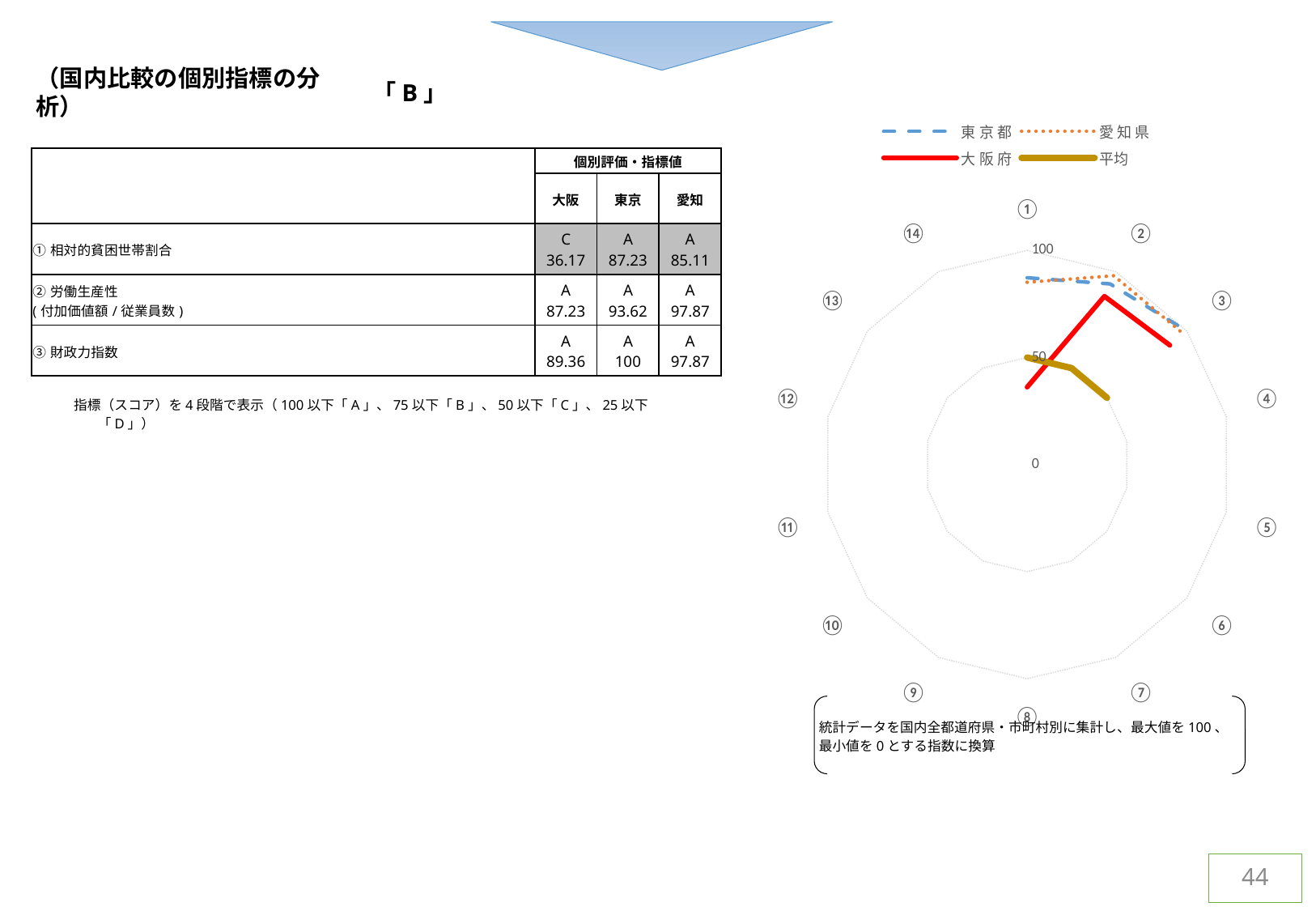
Which series in the radar chart is drawn as a solid red line? 大阪府 In the radar chart, which is larger at category ①: 大阪府 or 東京都? 東京都 Which series in the radar chart is drawn as a dotted orange line? 愛知県 In the radar chart, is the value for 東京都 at category ① greater or less than 50? greater In the radar chart, is the value for 大阪府 at category ② greater or less than 50? greater How many series does the legend of the radar chart list? 4 How many numbered categories are arranged around the radar chart? 14 In the radar chart, is the value for 大阪府 at category ① greater or less than 50? less What kind of chart is shown on the right of the slide? radar chart In the radar chart, which is larger at category ②: 大阪府 or 平均? 大阪府 In the radar chart, which series has the lowest value at category ①? 大阪府